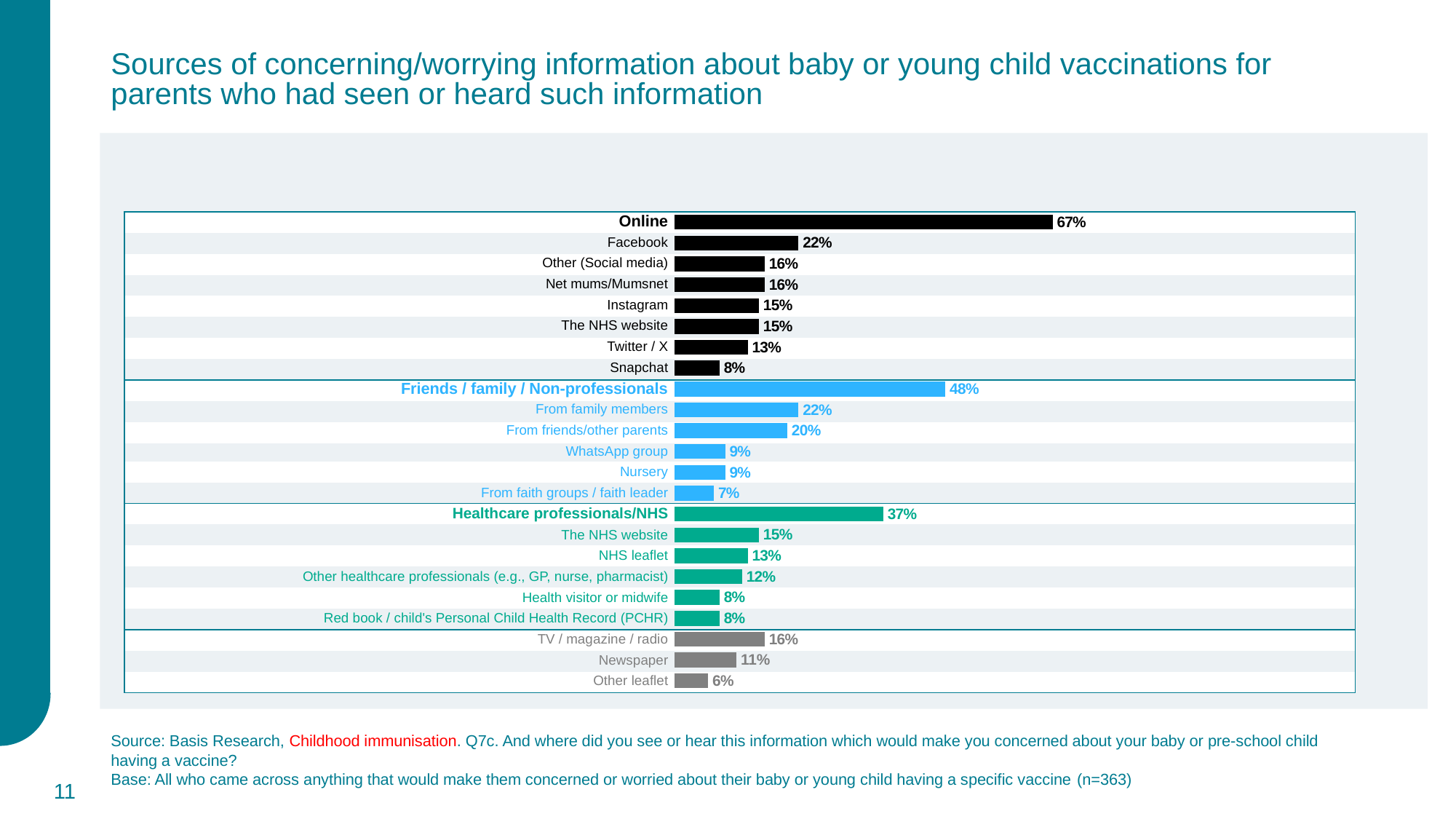
What percentage is shown for From faith groups / faith leader? 7% How many bars are plotted in the chart? 23 What percentage is shown for Online? 67% What kind of chart is shown on the slide? Bar chart Which source has the highest percentage? Online Which source has the lowest percentage? Other leaflet What percentage is shown for Newspaper? 11% What is the difference in percentage points between Online and Friends / family / Non-professionals? 19 percentage points What percentage is shown for Facebook? 22% Which is larger, Healthcare professionals/NHS or Friends / family / Non-professionals? Friends / family / Non-professionals What colour are the bars for the Online group of sources? Black What is the difference in percentage points between Facebook and Instagram? 7 percentage points